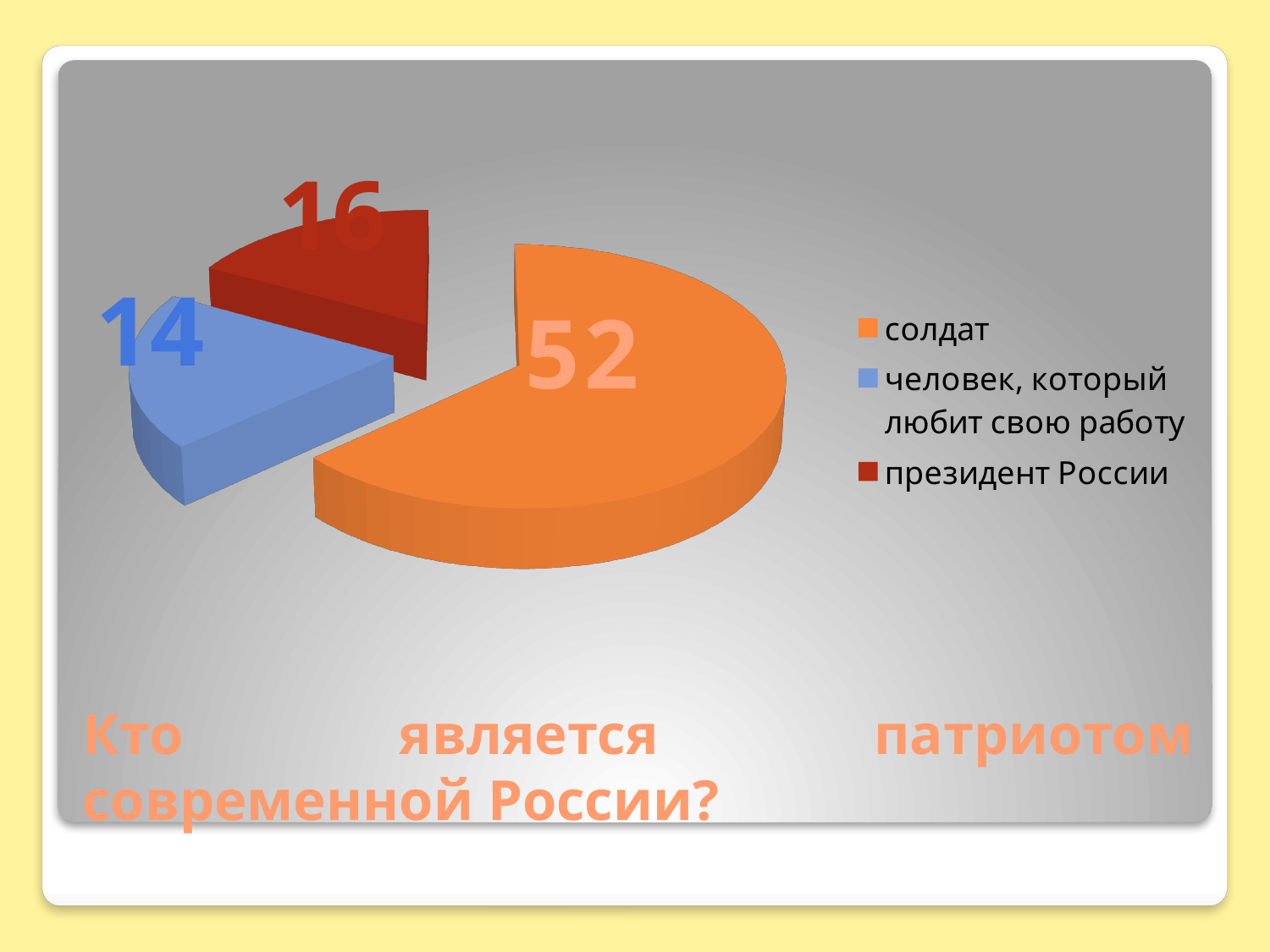
Which is larger: the value for президент России or the value for человек, который любит свою работу? президент России What is the value for человек, который любит свою работу in the pie chart? 14 What is the value for президент России in the pie chart? 16 What is the difference between the values for президент России and человек, который любит свою работу? 2 What is the difference between the values for солдат and президент России? 36 What kind of chart is shown on the slide? pie chart What is the value for солдат in the pie chart? 52 How many slices does the pie chart have? 3 Which category has the largest slice in the pie chart? солдат What is the total of all the values shown in the pie chart? 82 What colour is the slice for солдат? orange Which category has the smallest slice in the pie chart? человек, который любит свою работу